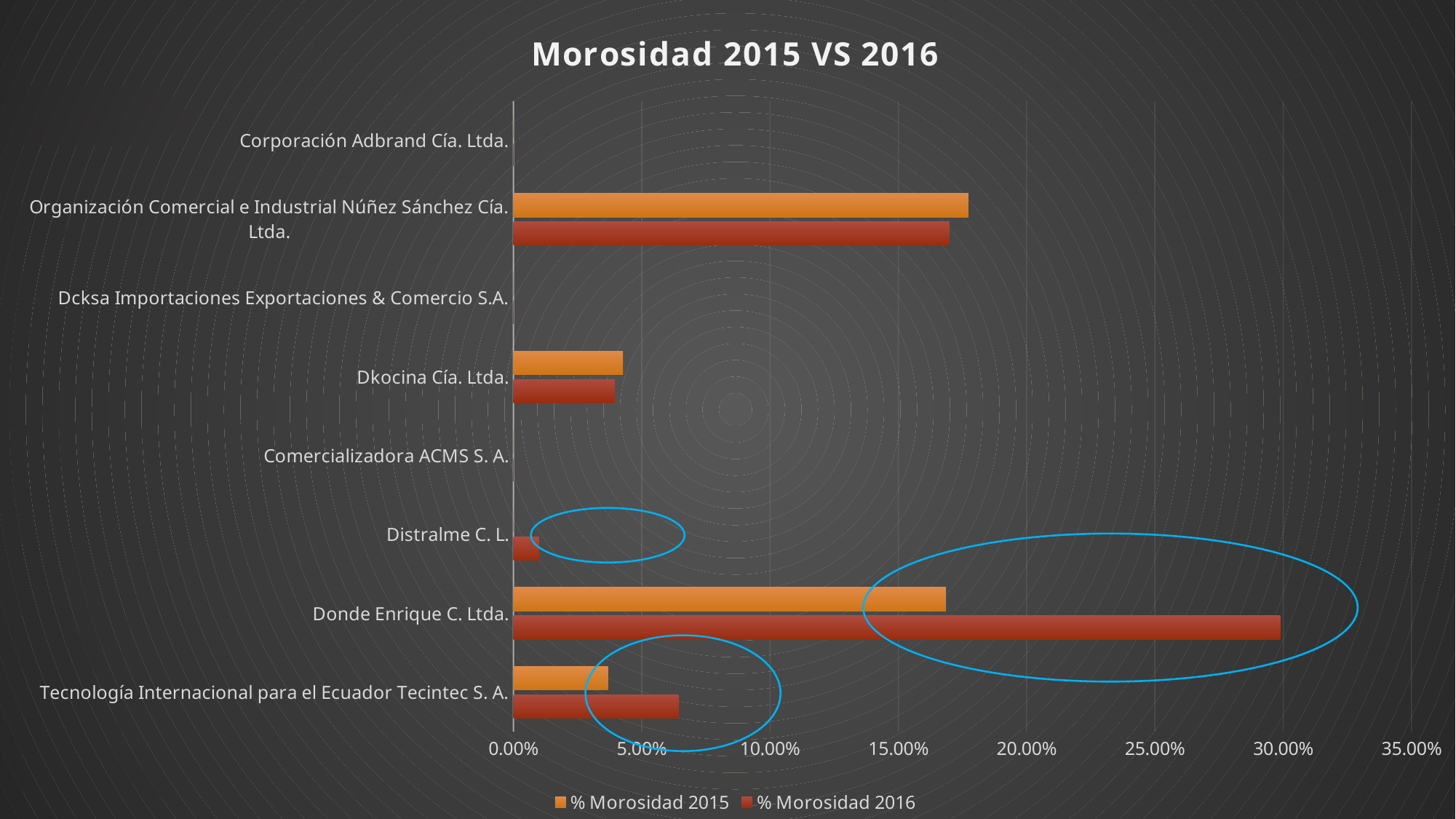
For Donde Enrique C. Ltda., which is larger: % Morosidad 2015 or % Morosidad 2016? % Morosidad 2016 What kind of chart is shown on the slide? Bar chart Is the % Morosidad 2015 value for Dkocina Cía. Ltda. greater or less than 5.00%? less Which company has the highest % Morosidad 2016 value? Donde Enrique C. Ltda. How many companies are listed on the vertical axis of the chart? 8 What is the title of the chart? Morosidad 2015 VS 2016 Is the % Morosidad 2016 value for Organización Comercial e Industrial Núñez Sánchez Cía. Ltda. greater or less than 15.00%? greater Is the % Morosidad 2016 value for Donde Enrique C. Ltda. greater or less than 25.00%? greater How many series does the legend list? 2 What is the highest value shown on the horizontal axis? 35.00% For Tecnología Internacional para el Ecuador Tecintec S. A., which is larger: % Morosidad 2015 or % Morosidad 2016? % Morosidad 2016